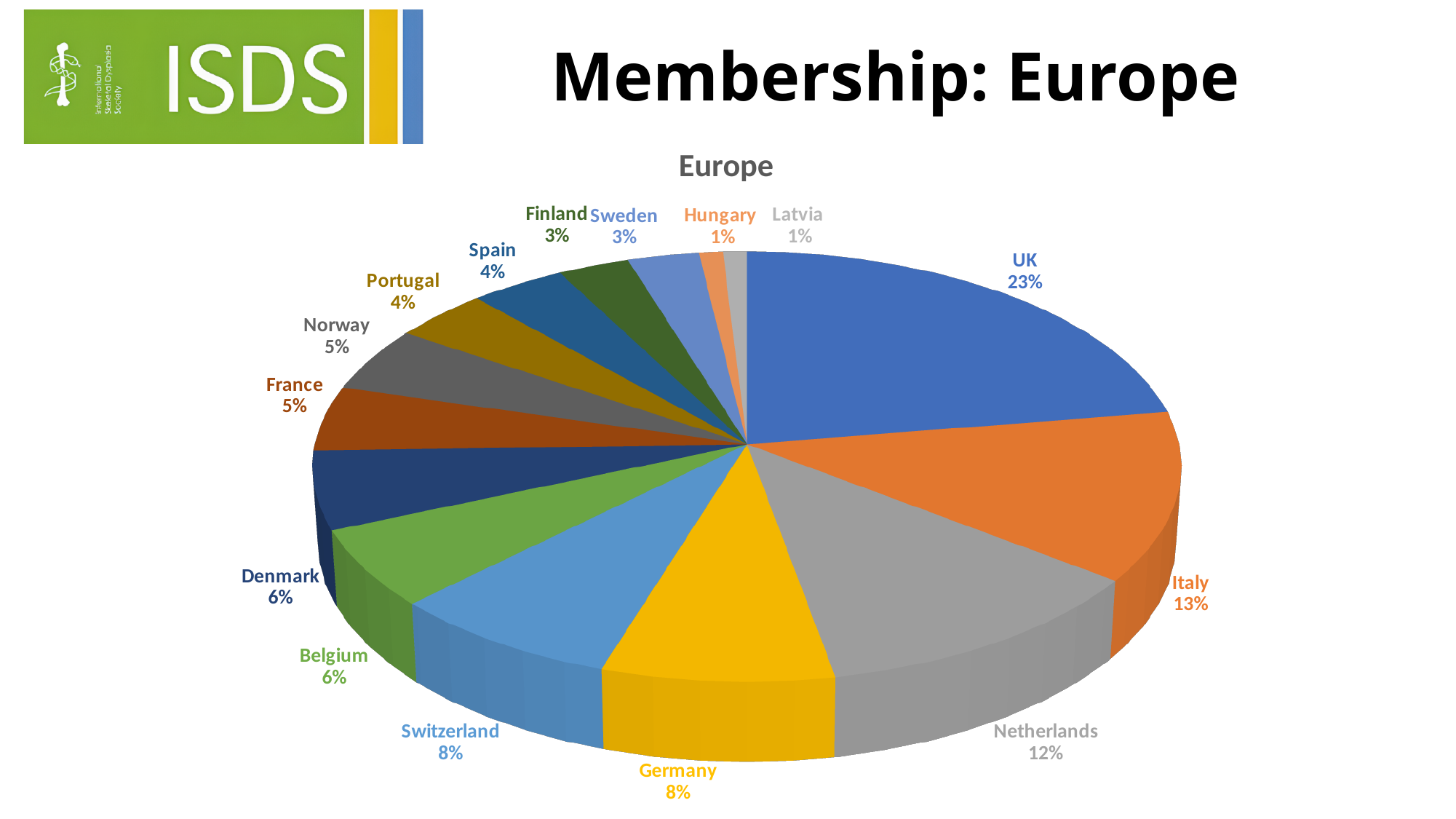
What type of chart is shown on the slide? Pie chart What is the title of the chart? Europe Which two countries share the smallest slices of the pie? Hungary and Latvia What is the difference in percentage points between Italy and the Netherlands? 1 What percentage is shown for Germany? 8% What percentage is shown for the Netherlands? 12% What share of the pie does the UK hold? 23% Which country has the largest slice of the pie? UK How many countries are shown in the pie chart? 15 What is the difference in percentage points between the UK and Italy? 10 Which has a larger share, Switzerland or Spain? Switzerland Which has a larger share, Denmark or France? Denmark